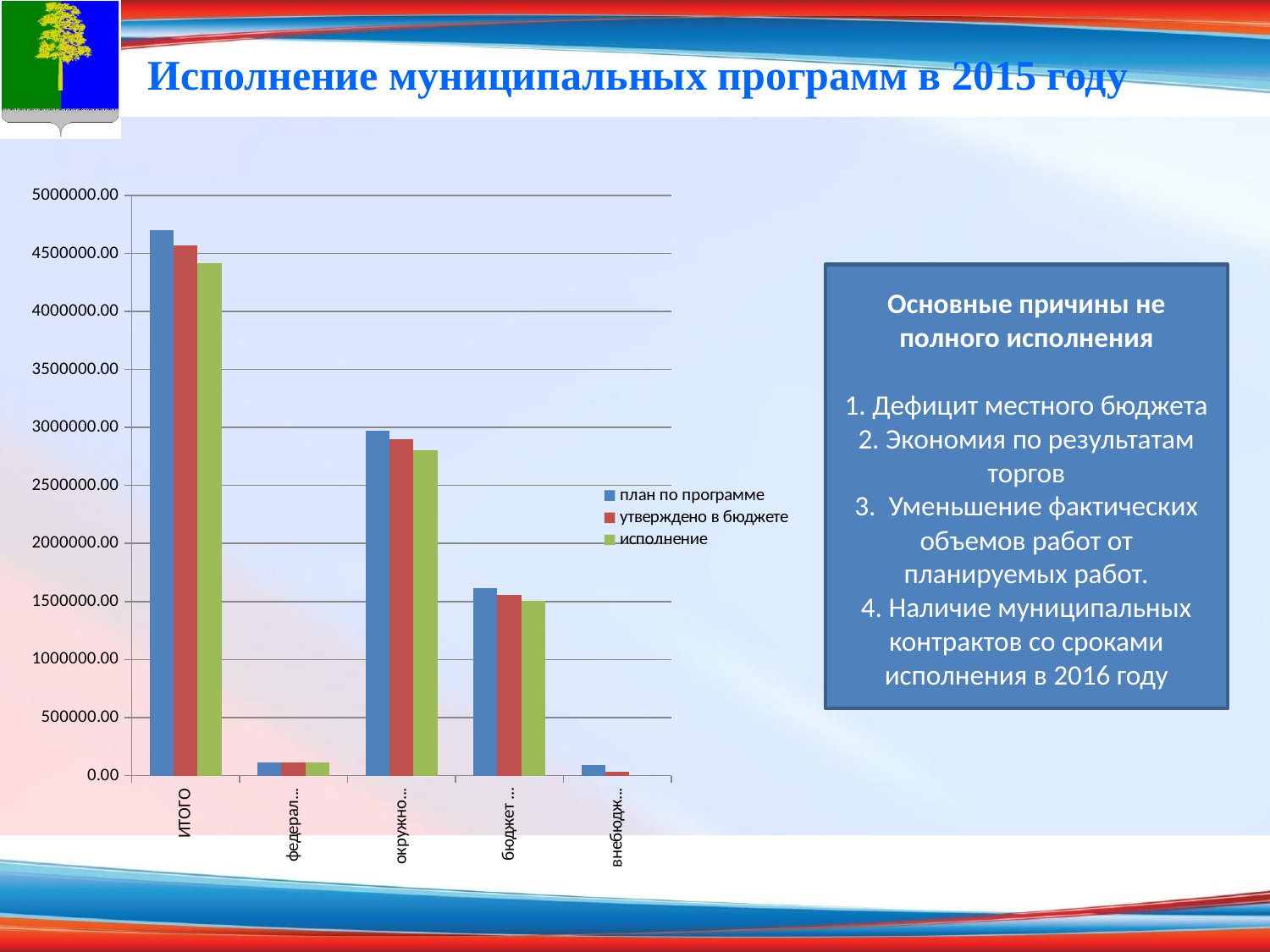
How many categories are shown on the x axis of the chart? 5 What are the three series listed in the chart legend? план по программе, утверждено в бюджете, исполнение For ИТОГО, which is larger: 'план по программе' or 'исполнение'? план по программе Is the value of 'план по программе' for the third category (окружно...) greater or less than 2500000.00? greater Is the value of 'исполнение' for ИТОГО greater or less than 4500000.00? less Is the value of 'план по программе' for ИТОГО greater or less than 4500000.00? greater For 'план по программе', which is larger: the third category (окружно...) or the fourth category (бюджет ...)? окружно... What kind of chart is shown on the slide? bar chart Which category has the highest value for the series 'план по программе'? ИТОГО How many series does the chart legend list? 3 What is the title of the slide containing the chart? Исполнение муниципальных программ в 2015 году